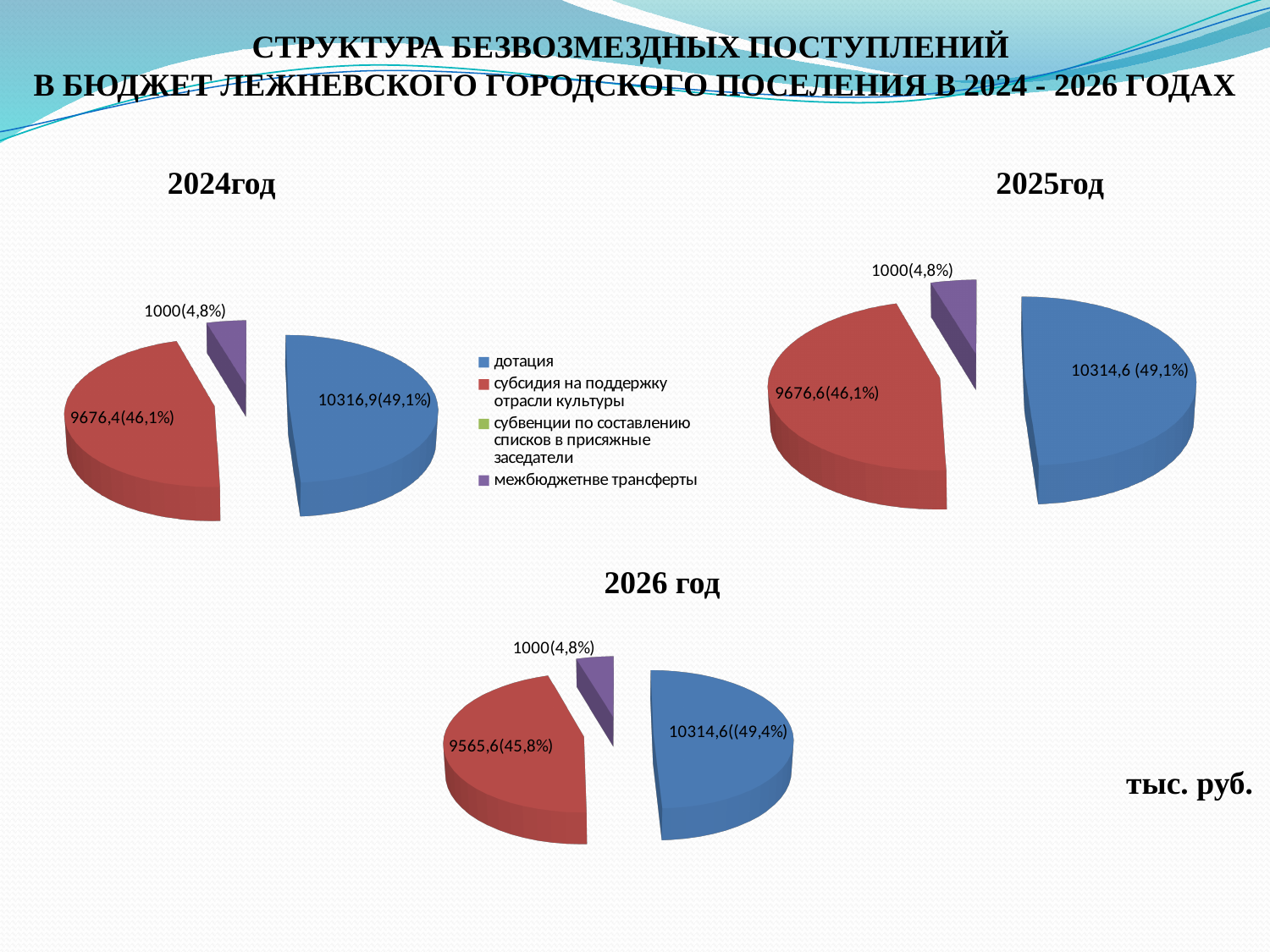
In the 2025год chart, what value is shown for субсидия на поддержку отрасли культуры? 9676,6 In the 2025год chart, what share of the pie does дотация have? 49,1% In the 2026 год chart, what share of the pie does межбюджетнве трансферты have? 4,8% In the 2024год chart, what share of the pie does субсидия на поддержку отрасли культуры have? 46,1% In the 2024год chart, which category has the largest slice? дотация In the 2025год chart, which is larger: дотация or субсидия на поддержку отрасли культуры? дотация How many entries does the legend list? 4 In the 2026 год chart, what value is shown for субсидия на поддержку отрасли культуры? 9565,6 In the 2026 год chart, which category has the smallest slice? межбюджетнве трансферты In the 2024год chart, what is the difference between the values for дотация and субсидия на поддержку отрасли культуры? 640,5 In the 2024год chart, what value is shown for дотация? 10316,9 What type of chart is used for the 2026 год data? Pie chart